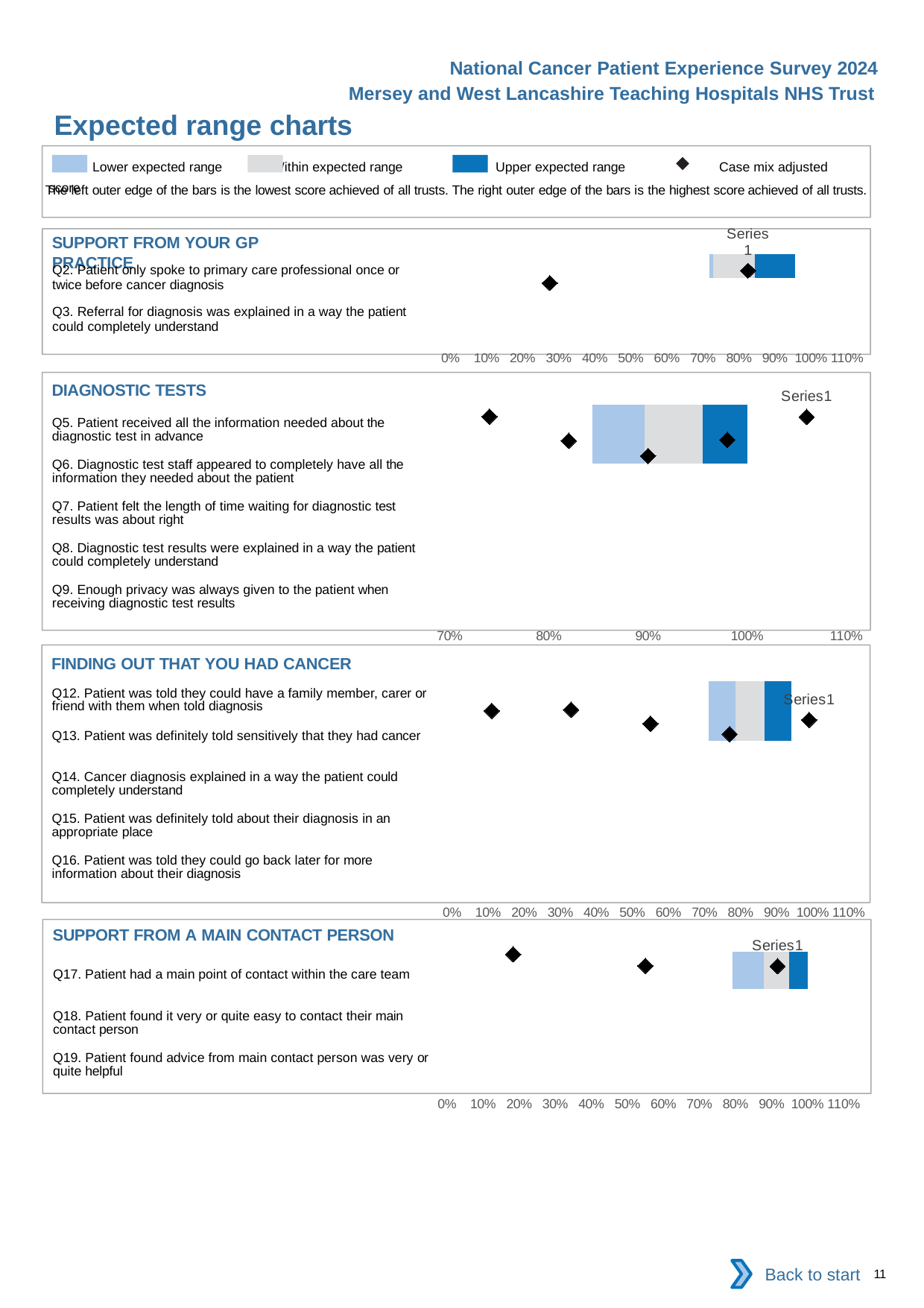
In the 'DIAGNOSTIC TESTS' chart, what is the lowest value shown on the x axis? 70% In the 'DIAGNOSTIC TESTS' chart, is the leftmost case mix adjusted score marker greater or less than 80%? less How many questions are listed in the 'DIAGNOSTIC TESTS' chart? 5 In the 'SUPPORT FROM YOUR GP PRACTICE' chart, what is the highest value shown on the x axis? 110% How many questions are listed in the 'FINDING OUT THAT YOU HAD CANCER' chart? 5 How many questions are listed in the 'SUPPORT FROM A MAIN CONTACT PERSON' chart? 3 What kind of chart is used in the 'DIAGNOSTIC TESTS' section? bar chart How many entries does the legend at the top of the slide list? 4 In the 'SUPPORT FROM A MAIN CONTACT PERSON' chart, is the leftmost case mix adjusted score marker greater or less than 30%? less